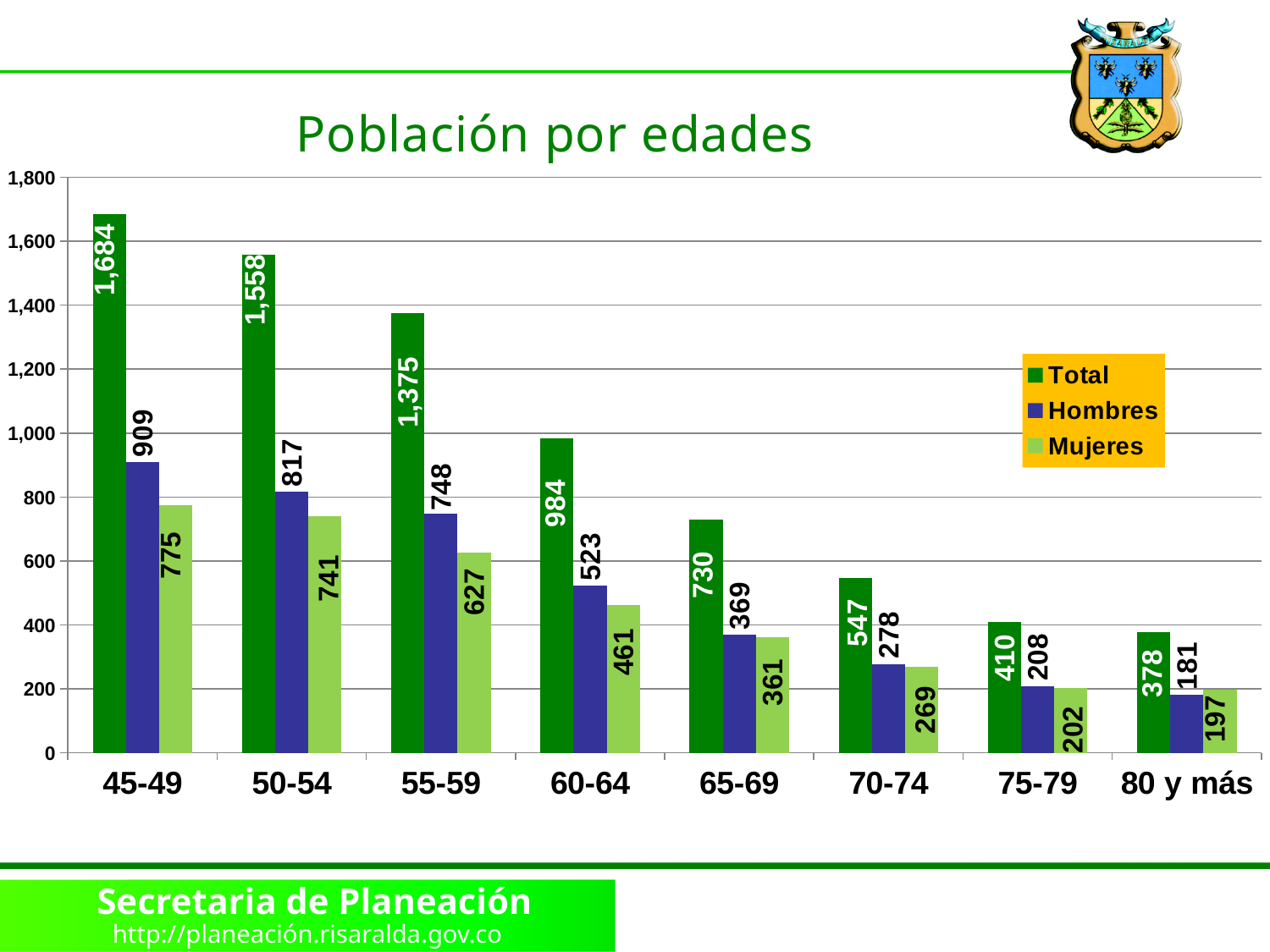
Which age group has the lowest Hombres value? 80 y más Do the Total values rise or fall from the 45-49 group to the 75-79 group? Fall What is the Hombres value for the 60-64 age group? 523 What is the title of the chart? Población por edades What kind of chart is shown on the slide? Bar chart How many age groups are shown on the x axis? 8 What is the Mujeres value for the 70-74 age group? 269 Which is larger for the 65-69 age group, Hombres or Mujeres? Hombres How many series does the legend list? 3 Which age group has the highest Total value? 45-49 What is the Total value for the 45-49 age group? 1,684 What is the difference between the Hombres and Mujeres values for the 55-59 age group? 121